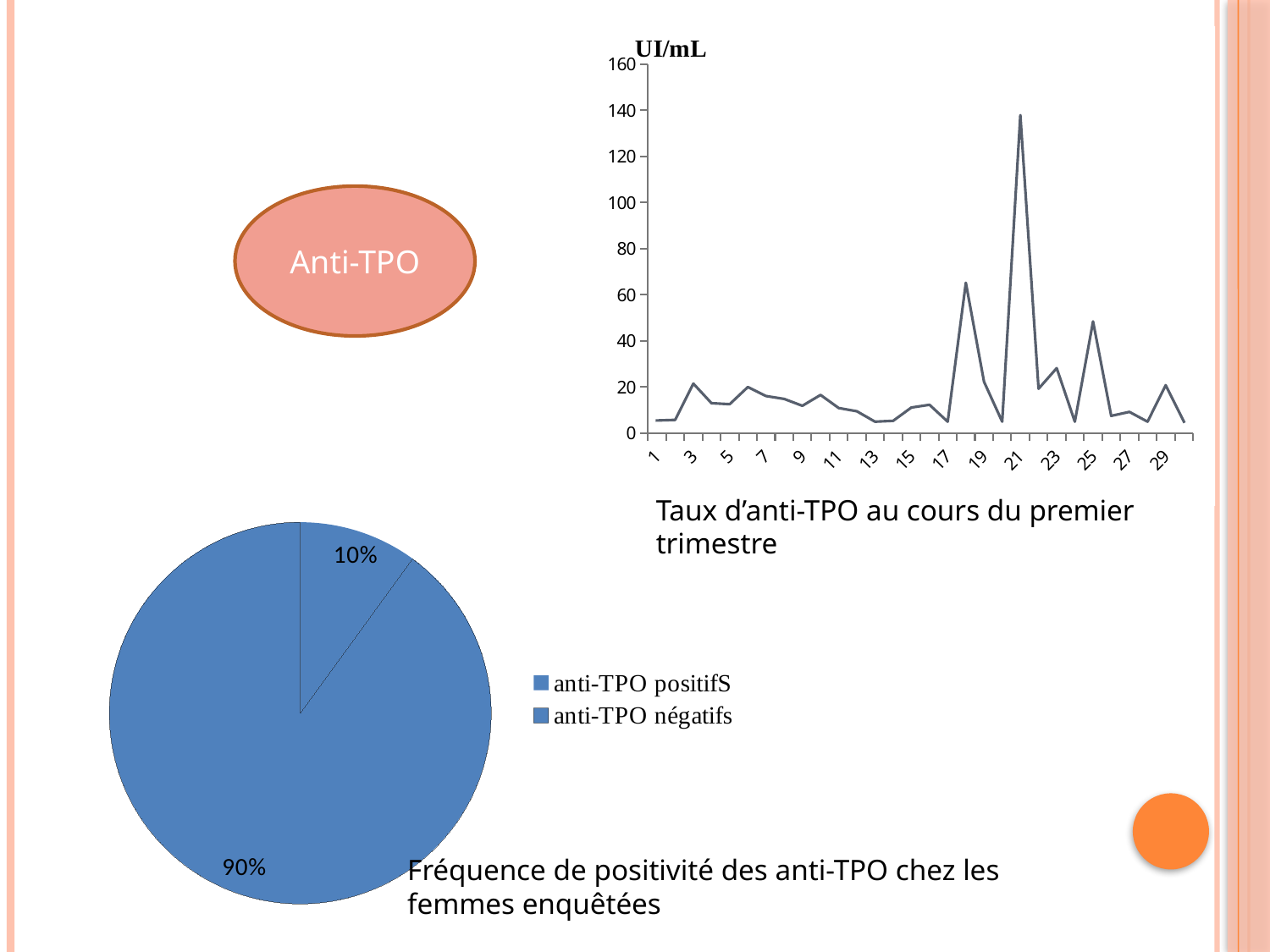
On the line chart 'Taux d'anti-TPO au cours du premier trimestre', which is larger, the value at 18 or the value at 25? 18 What unit is shown at the top of the y axis of the line chart 'Taux d'anti-TPO au cours du premier trimestre'? UI/mL On the line chart 'Taux d'anti-TPO au cours du premier trimestre', is the value at 25 greater or less than 40? greater On the line chart 'Taux d'anti-TPO au cours du premier trimestre', is the value at 1 greater or less than 20? less On the pie chart 'Fréquence de positivité des anti-TPO chez les femmes enquêtées', what share is labelled for anti-TPO négatifs? 90% On the pie chart 'Fréquence de positivité des anti-TPO chez les femmes enquêtées', which category has the larger share? anti-TPO négatifs On the line chart 'Taux d'anti-TPO au cours du premier trimestre', is the value at 21 greater or less than 120? greater On the pie chart 'Fréquence de positivité des anti-TPO chez les femmes enquêtées', what is the difference between the two slices' percentages? 80% What kind of chart is the chart titled 'Taux d'anti-TPO au cours du premier trimestre'? line chart On the line chart 'Taux d'anti-TPO au cours du premier trimestre', at which x-axis value does the line reach its highest point? 21 How many entries does the legend of the pie chart 'Fréquence de positivité des anti-TPO chez les femmes enquêtées' list? 2 On the pie chart 'Fréquence de positivité des anti-TPO chez les femmes enquêtées', what share is labelled for anti-TPO positifs? 10%